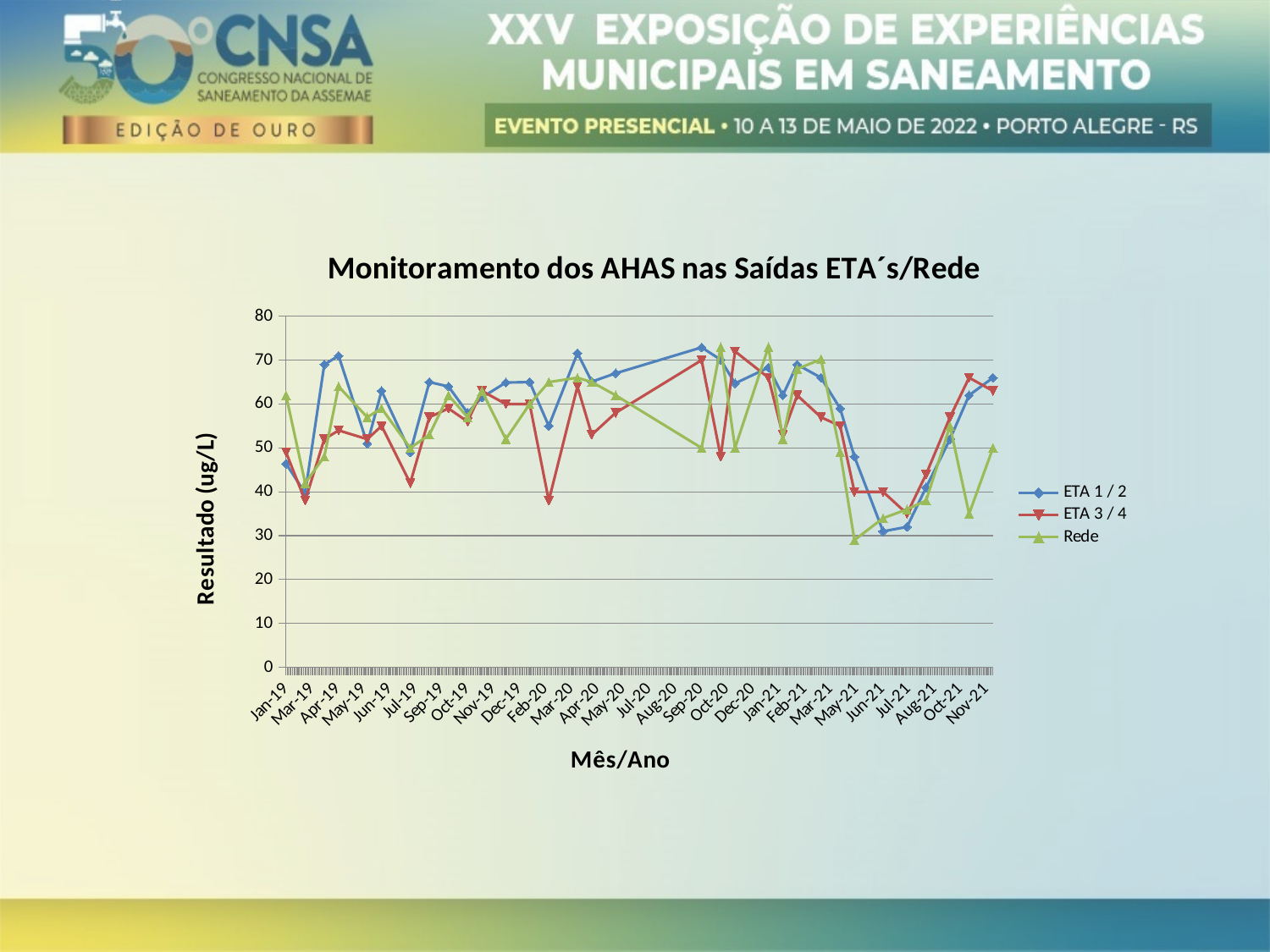
What is the title of the chart? Monitoramento dos AHAS nas Saídas ETA´s/Rede How many series does the legend list? 3 Between Jan-19 and Apr-19, does the ETA 1 / 2 series rise or fall overall? rise At Feb-20, which series has the higher value, ETA 1 / 2 or ETA 3 / 4? ETA 1 / 2 Is the value for ETA 1 / 2 at Jun-21 greater or less than 40? less Is the value for ETA 3 / 4 at Feb-20 greater or less than 50? less Is the value for Rede at Oct-20 greater or less than 60? greater At Apr-19, which series has the higher value, ETA 1 / 2 or ETA 3 / 4? ETA 1 / 2 What kind of chart is shown on the slide? line chart What is the label of the vertical axis? Resultado (ug/L)